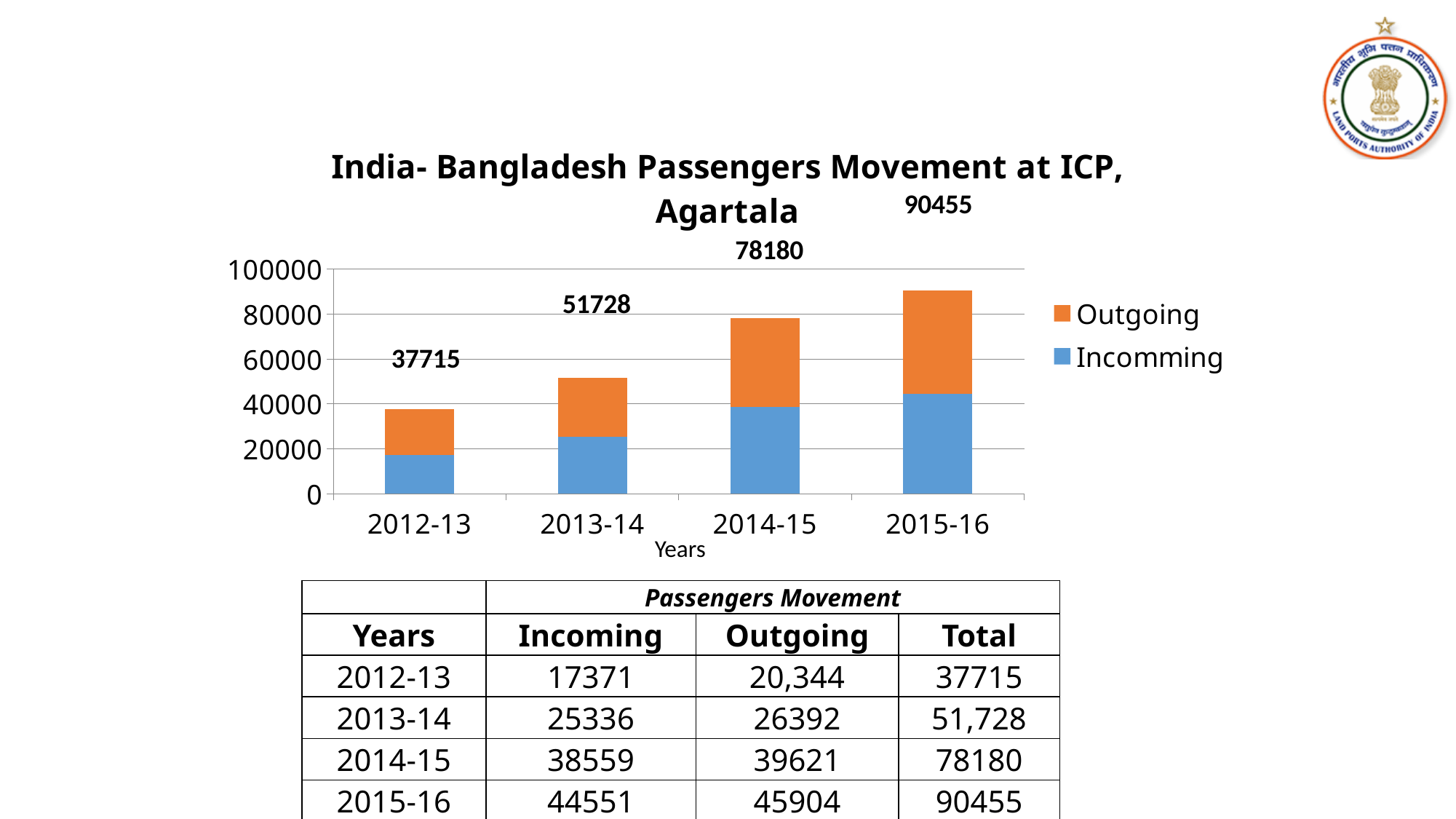
What kind of chart is shown on the slide? Stacked bar chart Is the Incomming value for 2015-16 greater or less than 40000? greater How many series does the chart legend list? 2 Which year has the lowest total passenger movement? 2012-13 Which colour represents the Outgoing series in the chart? Orange Do the total passenger movements rise or fall from 2012-13 to 2015-16? Rise Which year has the highest total passenger movement? 2015-16 What is the total passenger movement labelled above the bar for 2014-15? 78180 How many years are shown on the x axis of the chart? 4 What is the title of the chart? India- Bangladesh Passengers Movement at ICP, Agartala What is the total passenger movement labelled above the bar for 2012-13? 37715 What is the difference between the total passenger movement in 2015-16 and in 2014-15? 12275